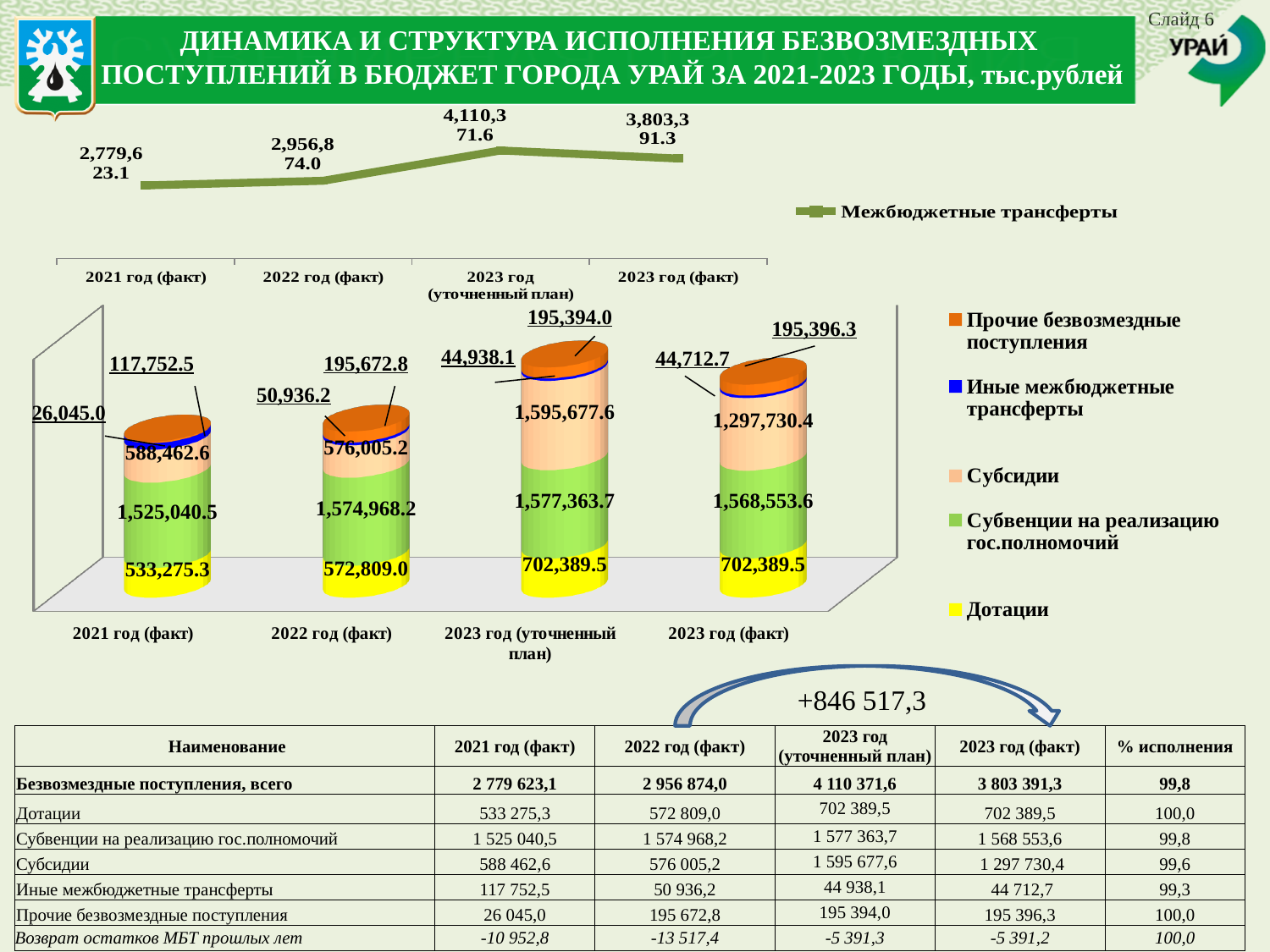
How many series does the legend of the stacked bar chart list? 5 In the stacked bar chart, what is the difference between Субсидии for 2023 год (уточненный план) and 2023 год (факт)? 297,947.2 In the stacked bar chart, what is the value of Субвенции на реализацию гос.полномочий for 2022 год (факт)? 1,574,968.2 In the stacked bar chart, in which category is Иные межбюджетные трансферты the highest? 2021 год (факт) In the stacked bar chart, in which category is Прочие безвозмездные поступления the lowest? 2021 год (факт) In the stacked bar chart, what is the value of Прочие безвозмездные поступления for 2022 год (факт)? 195,672.8 In the stacked bar chart, what is the value of Дотации for 2021 год (факт)? 533,275.3 In the stacked bar chart, which is larger: Дотации for 2021 год (факт) or for 2022 год (факт)? 2022 год (факт) What kind of chart is the lower chart on the slide? Bar chart In the stacked bar chart, what is the value of Иные межбюджетные трансферты for 2021 год (факт)? 117,752.5 In the line chart Межбюджетные трансферты at the top, does the line rise or fall from 2021 год (факт) to 2023 год (уточненный план)? Rise In the stacked bar chart, what is the value of Субсидии for 2023 год (факт)? 1,297,730.4